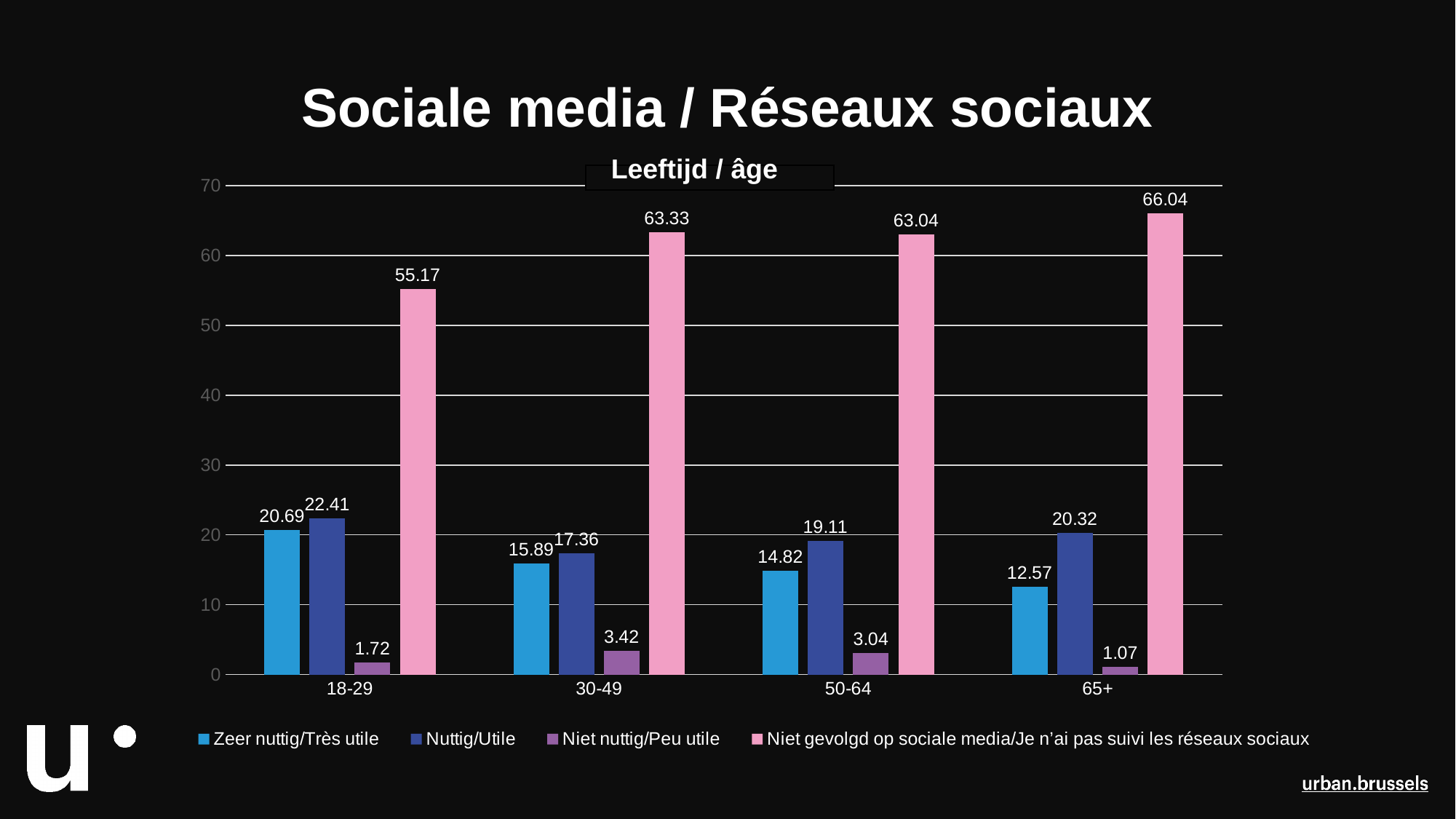
What is the value for 'Niet gevolgd op sociale media/Je n'ai pas suivi les réseaux sociaux' in the 18-29 age group? 55.17 What is the difference between the 'Nuttig/Utile' and 'Zeer nuttig/Très utile' values in the 18-29 age group? 1.72 Which age group has the highest value for 'Niet gevolgd op sociale media/Je n'ai pas suivi les réseaux sociaux'? 65+ How many age groups are shown on the x axis? 4 What is the value for 'Nuttig/Utile' in the 50-64 age group? 19.11 Which age group has the lowest value for 'Niet nuttig/Peu utile'? 65+ What is the value for 'Niet nuttig/Peu utile' in the 30-49 age group? 3.42 How many series does the legend list? 4 What kind of chart is shown on the slide? Bar chart Which is larger in the 30-49 age group: 'Zeer nuttig/Très utile' or 'Nuttig/Utile'? Nuttig/Utile What is the value for 'Zeer nuttig/Très utile' in the 65+ age group? 12.57 Does the value for 'Zeer nuttig/Très utile' rise or fall across the age groups from 18-29 to 65+? Fall